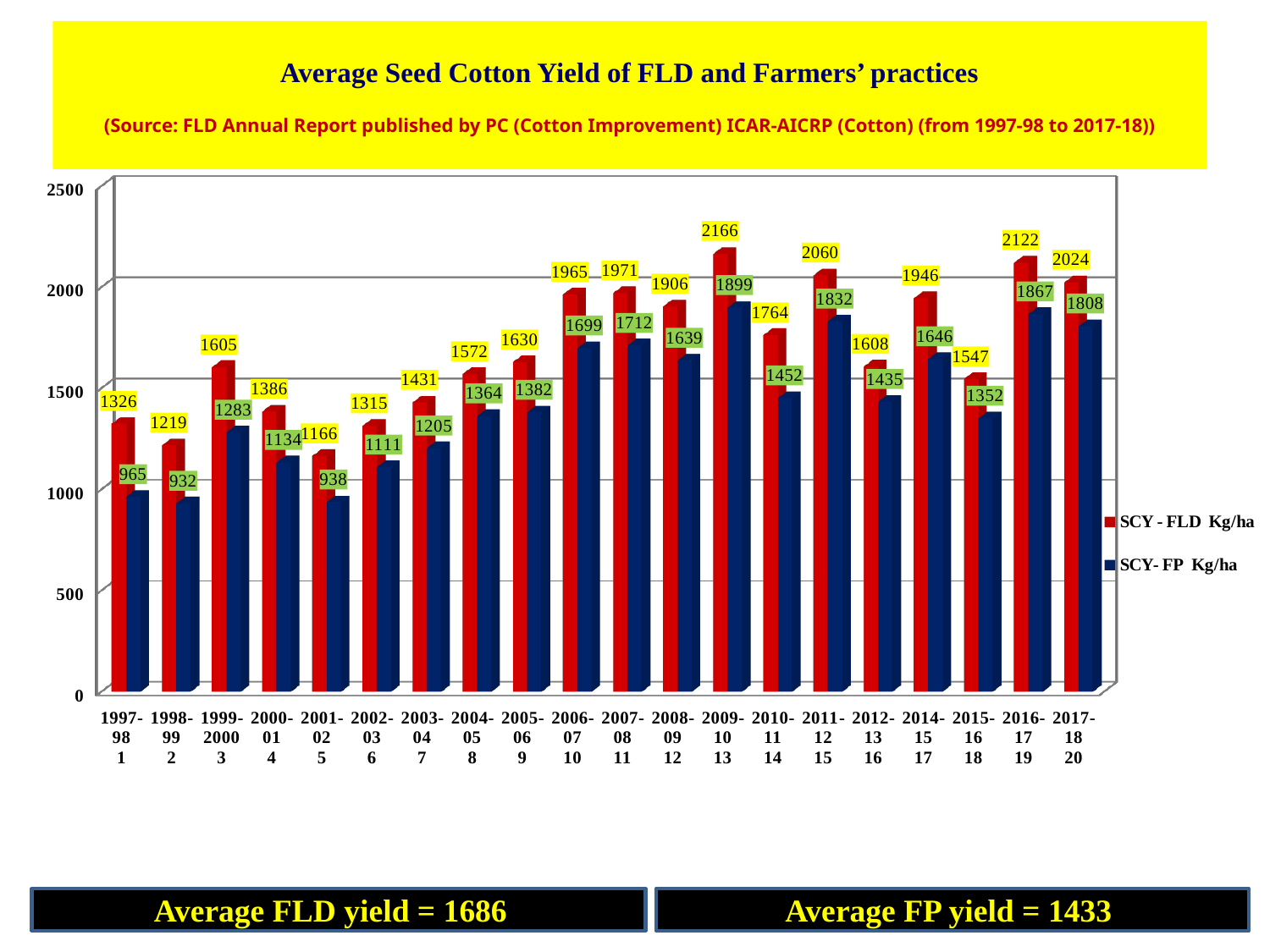
Which year has the lowest SCY-FP value? 1998-99 What is the SCY-FLD value for 2016-17? 2122 Which is larger, the SCY-FLD value for 2011-12 or the SCY-FLD value for 2014-15? 2011-12 How many series does the legend list? 2 What kind of chart is shown on the slide? Bar chart How many years are shown on the x axis? 20 What is the difference between the SCY-FLD and SCY-FP values for 2009-10? 267 What is the title of the chart? Average Seed Cotton Yield of FLD and Farmers' practices What is the SCY-FLD value for 2009-10? 2166 What is the SCY-FP value for 1997-98? 965 Which year has the lowest SCY-FLD value? 2001-02 Which year has the highest SCY-FLD value? 2009-10